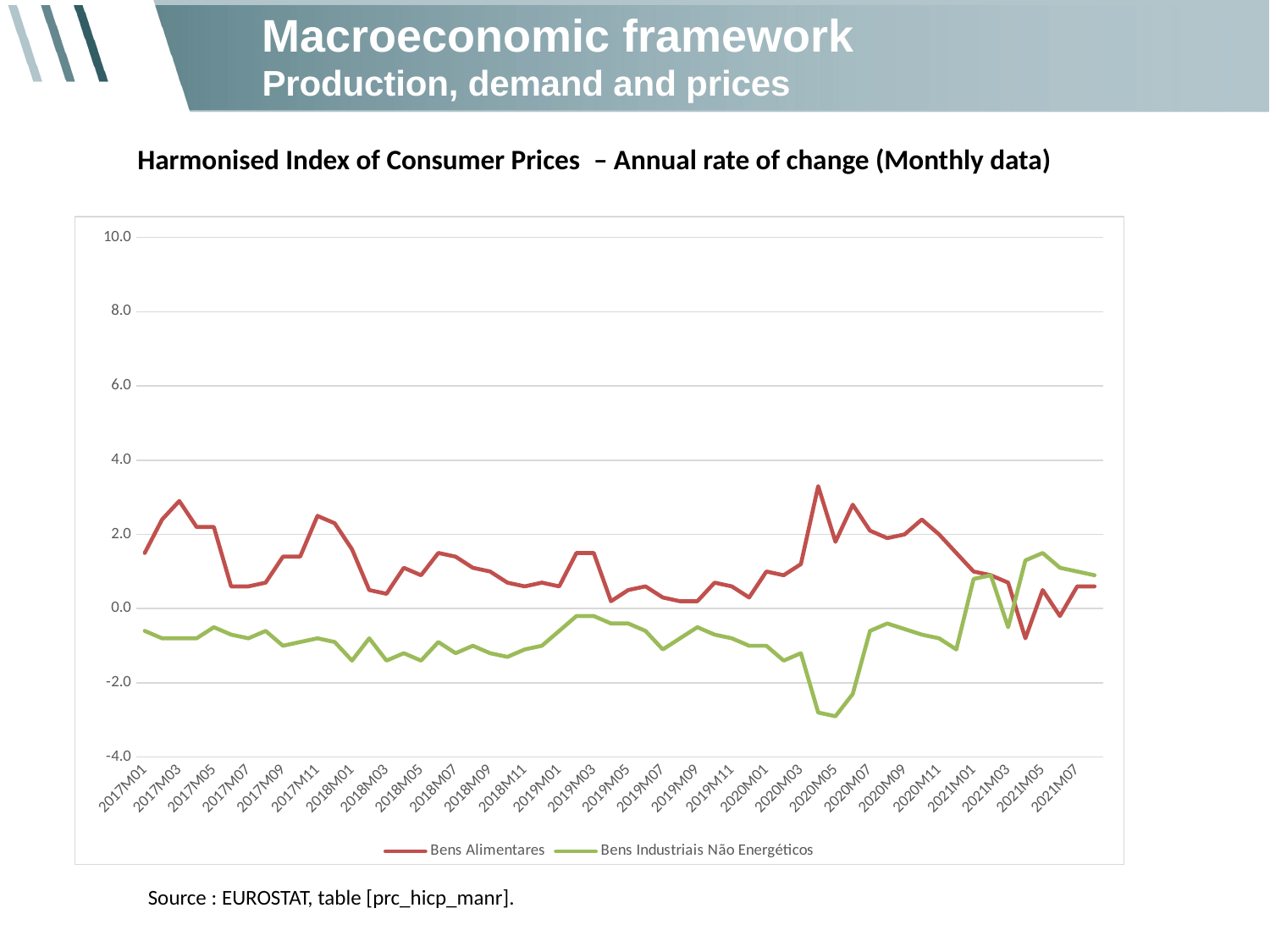
At 2020M04, which series has the higher value, Bens Alimentares or Bens Industriais Não Energéticos? Bens Alimentares Which series reaches the highest value anywhere on the chart? Bens Alimentares Is the value for Bens Industriais Não Energéticos at 2020M05 greater or less than -2.0? less What is the title of the chart? Harmonised Index of Consumer Prices – Annual rate of change (Monthly data) Is the value for Bens Industriais Não Energéticos at 2017M01 greater or less than 0.0? less Which series reaches the lowest value anywhere on the chart? Bens Industriais Não Energéticos How many series does the legend list? 2 From 2020M11 to 2021M01, does the Bens Alimentares line rise or fall? fall What kind of chart is shown on the slide? Line chart What are the two series named in the legend? Bens Alimentares and Bens Industriais Não Energéticos At 2021M05, which series has the higher value, Bens Alimentares or Bens Industriais Não Energéticos? Bens Industriais Não Energéticos Is the value for Bens Alimentares at 2017M03 greater or less than 2.0? greater